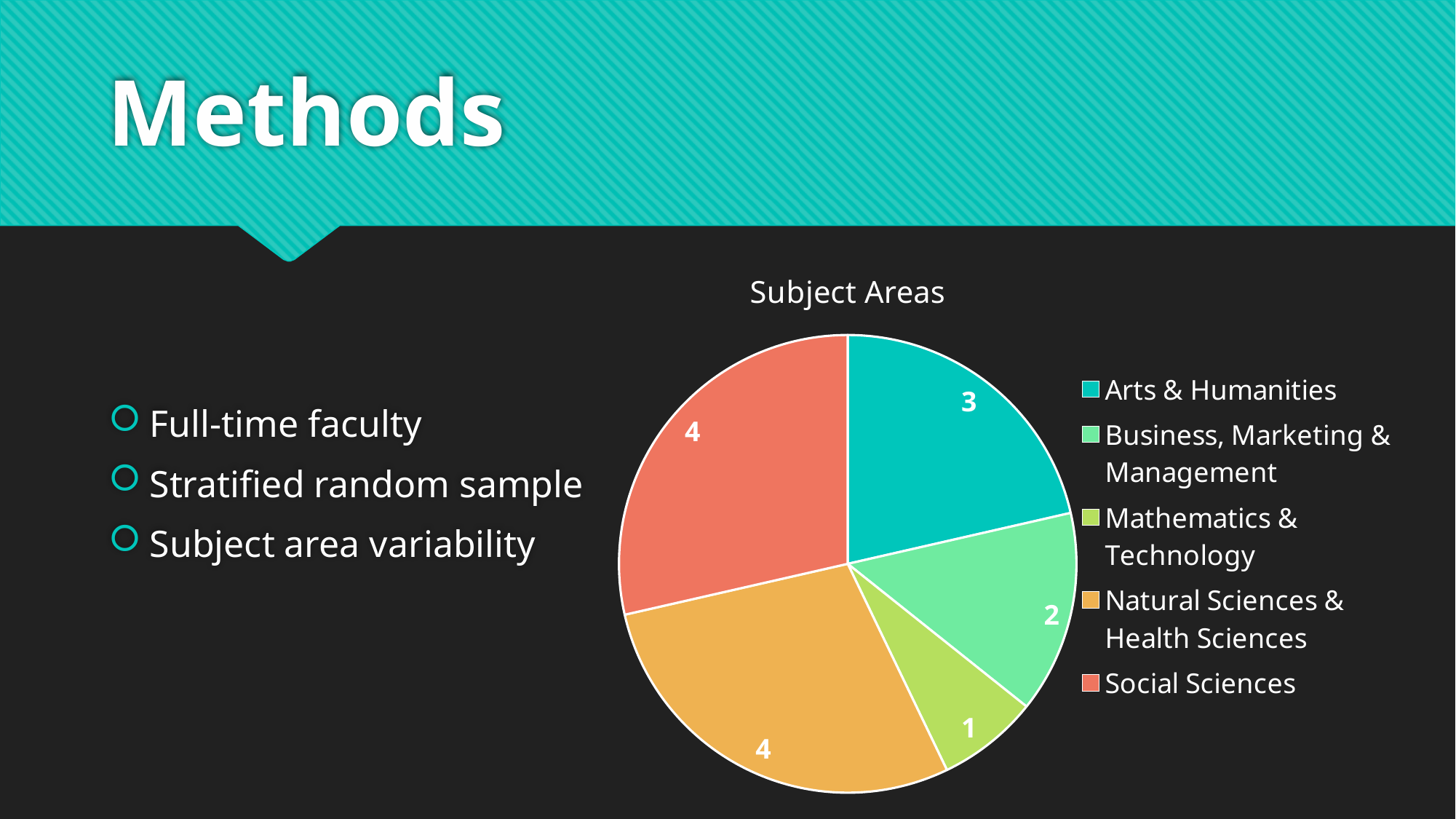
Which colour represents Social Sciences in the pie chart? red/salmon What is the title of the chart? Subject Areas Which subject area has the smallest slice in the pie chart? Mathematics & Technology Which is larger, the value for Arts & Humanities or the value for Mathematics & Technology? Arts & Humanities What is the total of all the values in the Subject Areas pie chart? 14 What is the value for Mathematics & Technology in the Subject Areas pie chart? 1 How many subject areas are shown in the pie chart? 5 What type of chart is shown on the slide? pie chart What is the difference between the values for Natural Sciences & Health Sciences and Business, Marketing & Management? 2 What is the value for Arts & Humanities in the Subject Areas pie chart? 3 What is the value for Business, Marketing & Management in the Subject Areas pie chart? 2 What is the value for Social Sciences in the Subject Areas pie chart? 4